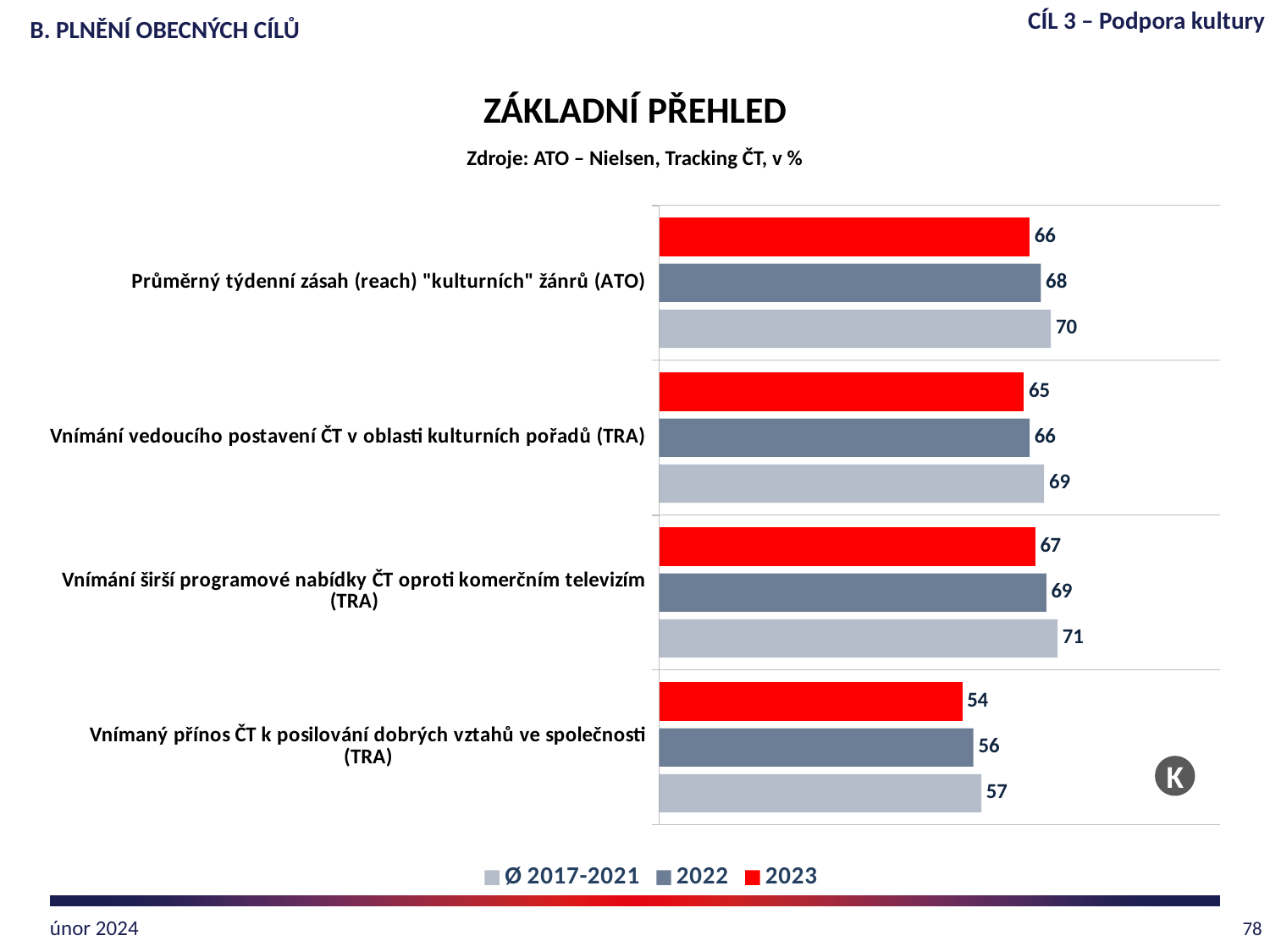
Which is larger for "Vnímání vedoucího postavení ČT v oblasti kulturních pořadů (TRA)": the 2022 value or the 2023 value? 2022 What kind of chart is shown on the slide? Bar chart How many categories are shown in the chart? 4 What is the 2022 value for "Vnímaný přínos ČT k posilování dobrých vztahů ve společnosti (TRA)"? 56 How many series does the legend list? 3 Which category has the highest 2023 value? Vnímání širší programové nabídky ČT oproti komerčním televizím (TRA) What is the 2023 value for "Průměrný týdenní zásah (reach) "kulturních" žánrů (ATO)"? 66 What is the Ø 2017-2021 value for "Vnímání vedoucího postavení ČT v oblasti kulturních pořadů (TRA)"? 69 Which category has the lowest Ø 2017-2021 value? Vnímaný přínos ČT k posilování dobrých vztahů ve společnosti (TRA) What is the difference between the Ø 2017-2021 and 2023 values for "Vnímání širší programové nabídky ČT oproti komerčním televizím (TRA)"? 4 What is the title of the chart? ZÁKLADNÍ PŘEHLED Which series is shown in red? 2023